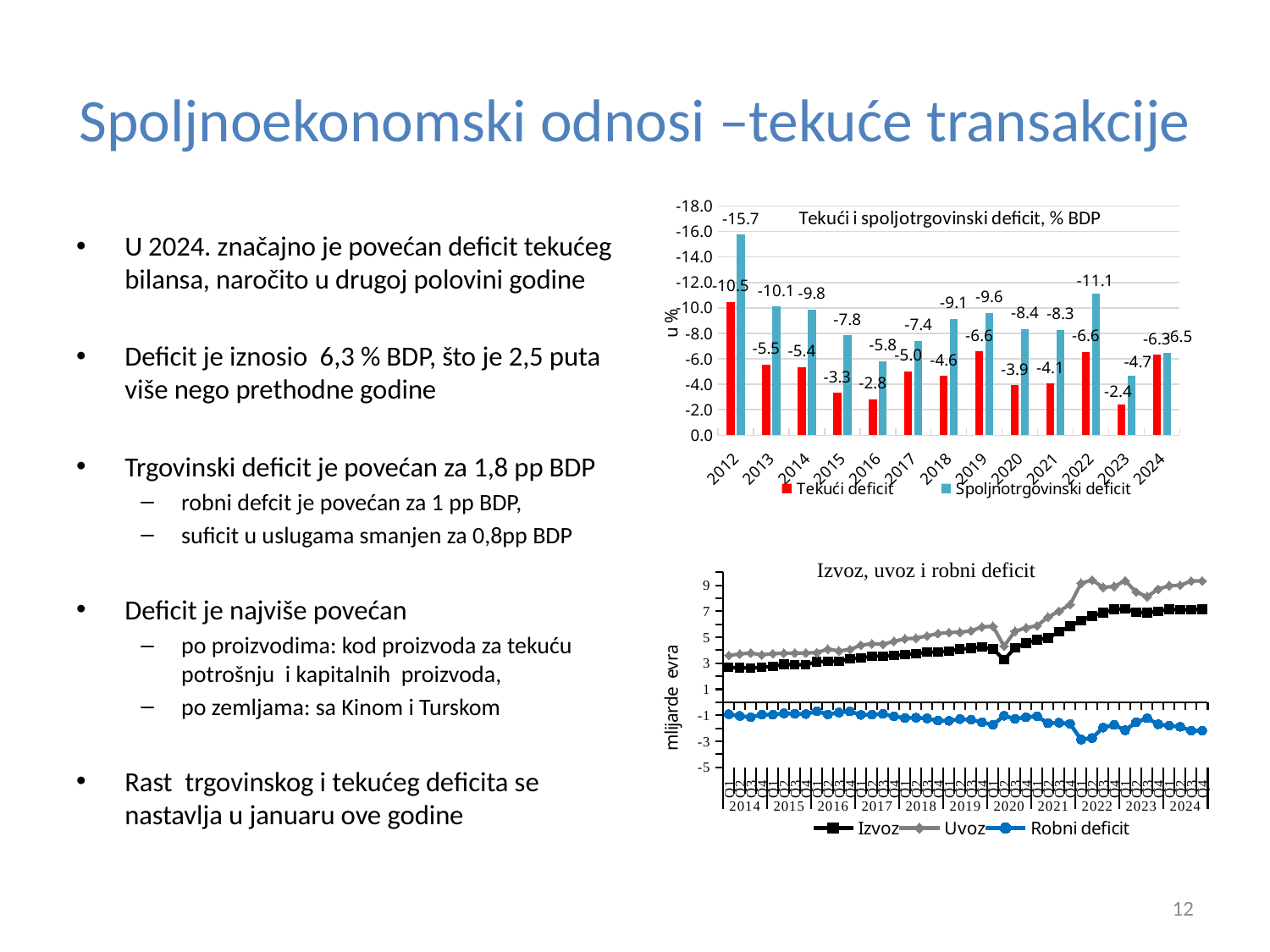
In the chart titled "Tekući i spoljotrgovinski deficit, % BDP", what is the value of Tekući deficit for 2012? -10.5 In the chart titled "Tekući i spoljotrgovinski deficit, % BDP", is the Tekući deficit bar taller in 2019 or in 2020? 2019 In the chart titled "Tekući i spoljotrgovinski deficit, % BDP", what is the difference between the Spoljnotrgovinski deficit and the Tekući deficit in 2013? 4.6 In the chart titled "Tekući i spoljotrgovinski deficit, % BDP", how many years are shown on the x axis? 13 In the chart titled "Tekući i spoljotrgovinski deficit, % BDP", what is the value of Tekući deficit for 2023? -2.4 What kind of chart is the top chart on the slide, titled "Tekući i spoljotrgovinski deficit, % BDP"? bar chart In the chart titled "Tekući i spoljotrgovinski deficit, % BDP", which year has the smallest Tekući deficit bar? 2023 In the chart titled "Izvoz, uvoz i robni deficit", what is the label of the y axis? mlijarde evra In the chart titled "Tekući i spoljotrgovinski deficit, % BDP", which year has the largest Spoljnotrgovinski deficit bar? 2012 In the chart titled "Izvoz, uvoz i robni deficit", how many series does the legend list? 3 In the chart titled "Tekući i spoljotrgovinski deficit, % BDP", how many series does the legend list? 2 In the chart titled "Tekući i spoljotrgovinski deficit, % BDP", what is the value of Spoljnotrgovinski deficit for 2022? -11.1